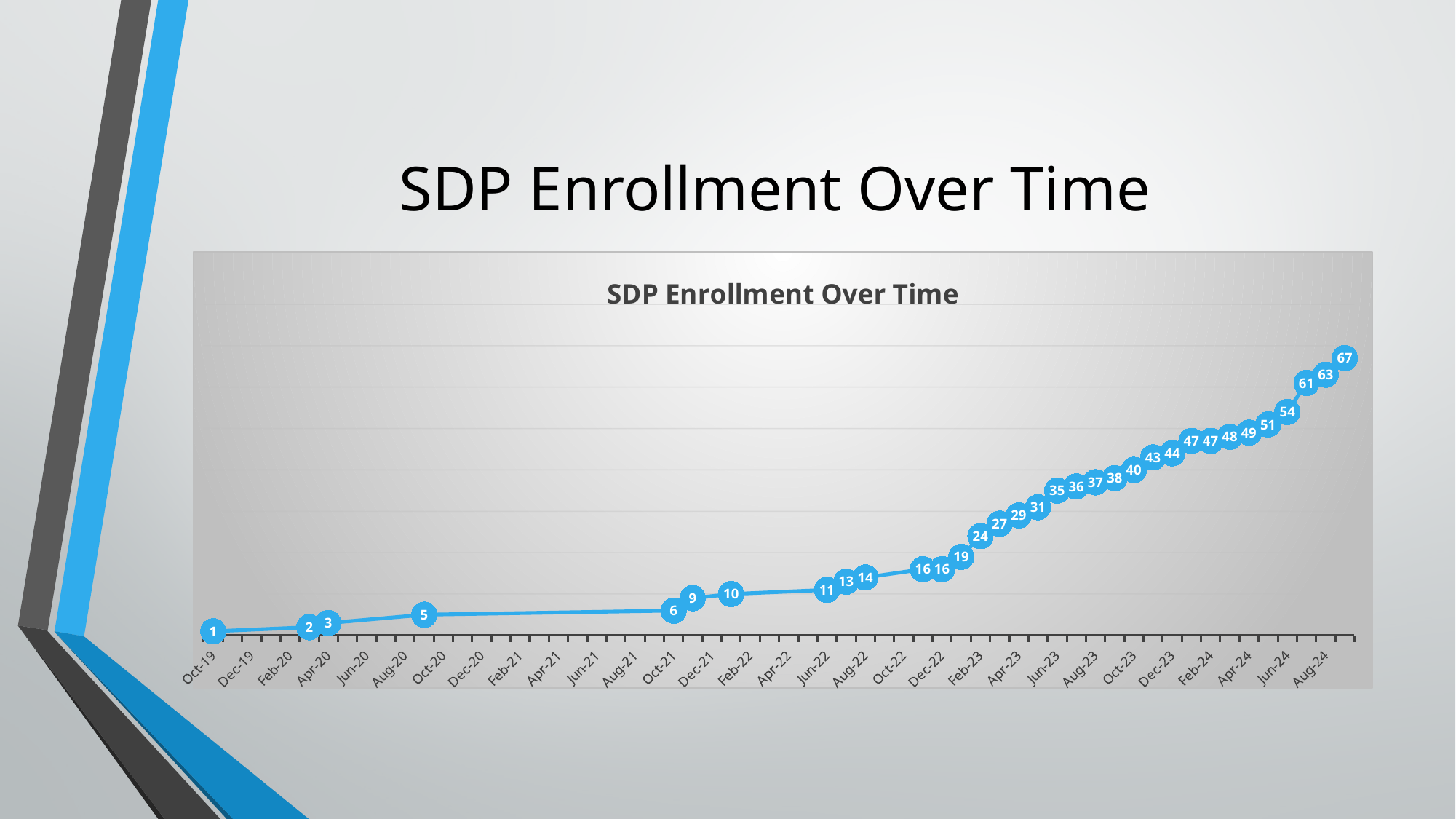
What is the enrollment value at Apr-20? 3 What is the lowest enrollment value shown on the chart? 1 What is the enrollment value at the first data point (Oct-19)? 1 What is the enrollment value at the last data point on the chart? 67 What is the difference between the last data point (67) and the first data point (1)? 66 What is the first label on the x axis? Oct-19 How many data points are plotted on the line? 33 What is the title of the chart? SDP Enrollment Over Time What type of chart is shown on the slide? line chart What is the highest enrollment value shown on the chart? 67 What is the difference between the last two data points, 63 and 67? 4 Do the enrollment values generally rise or fall from left to right along the x axis? rise